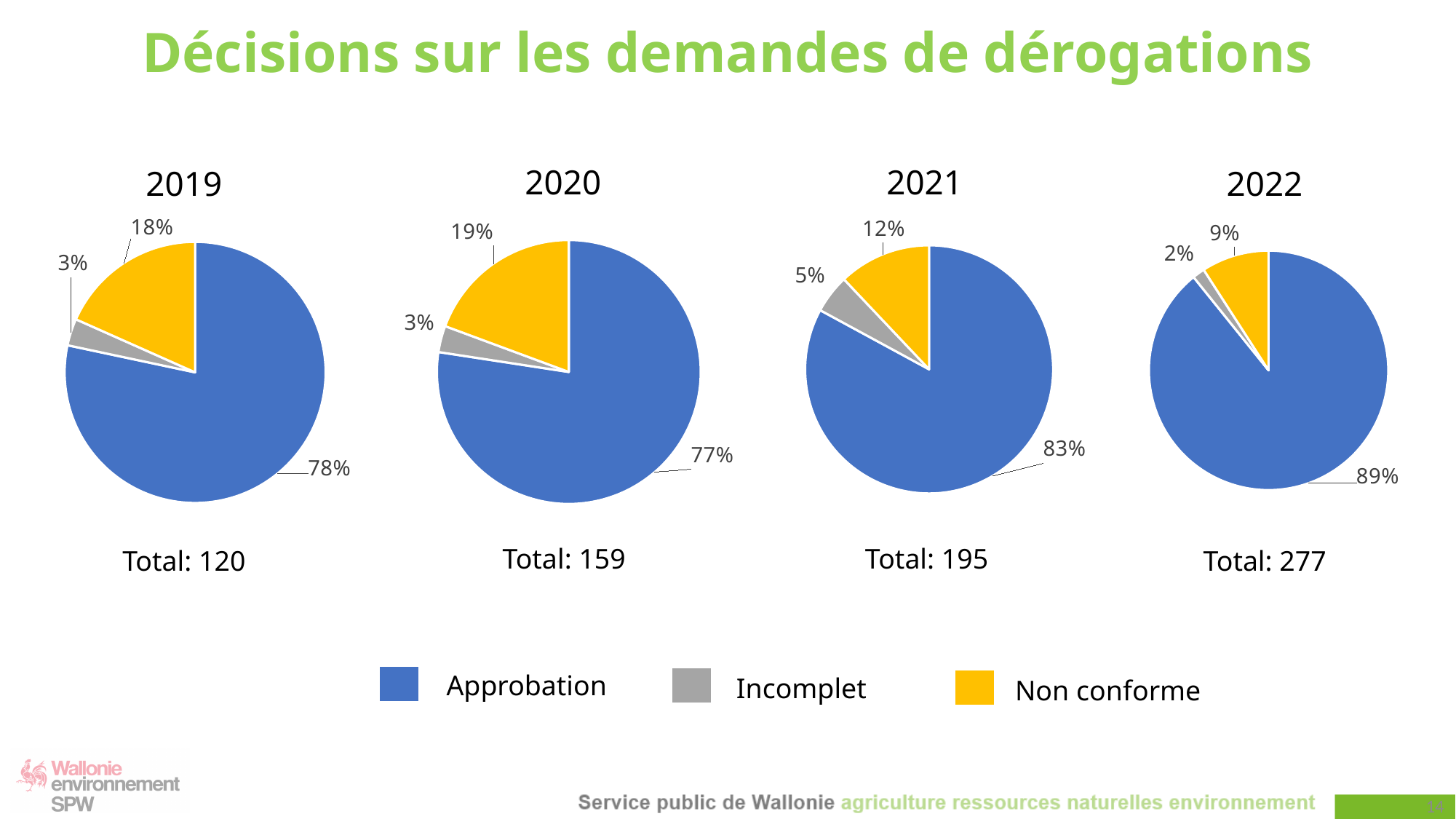
What is the total number of decisions shown for 2021? 195 In the 2019 pie chart, what share is Approbation? 78% How many categories does the legend list? 3 In the 2022 pie chart, which category has the smallest share? Incomplet In the 2020 pie chart, what share is Non conforme? 19% In the 2021 pie chart, which category has the largest share? Approbation How many pie charts are on the slide? 4 In the 2022 pie chart, what share is Approbation? 89% What kind of chart is used for each year on the slide? Pie chart In the 2021 pie chart, what share is Incomplet? 5% Is the Non conforme share larger in 2020 or in 2022? 2020 What is the difference between the Approbation share in 2022 and in 2019? 11%